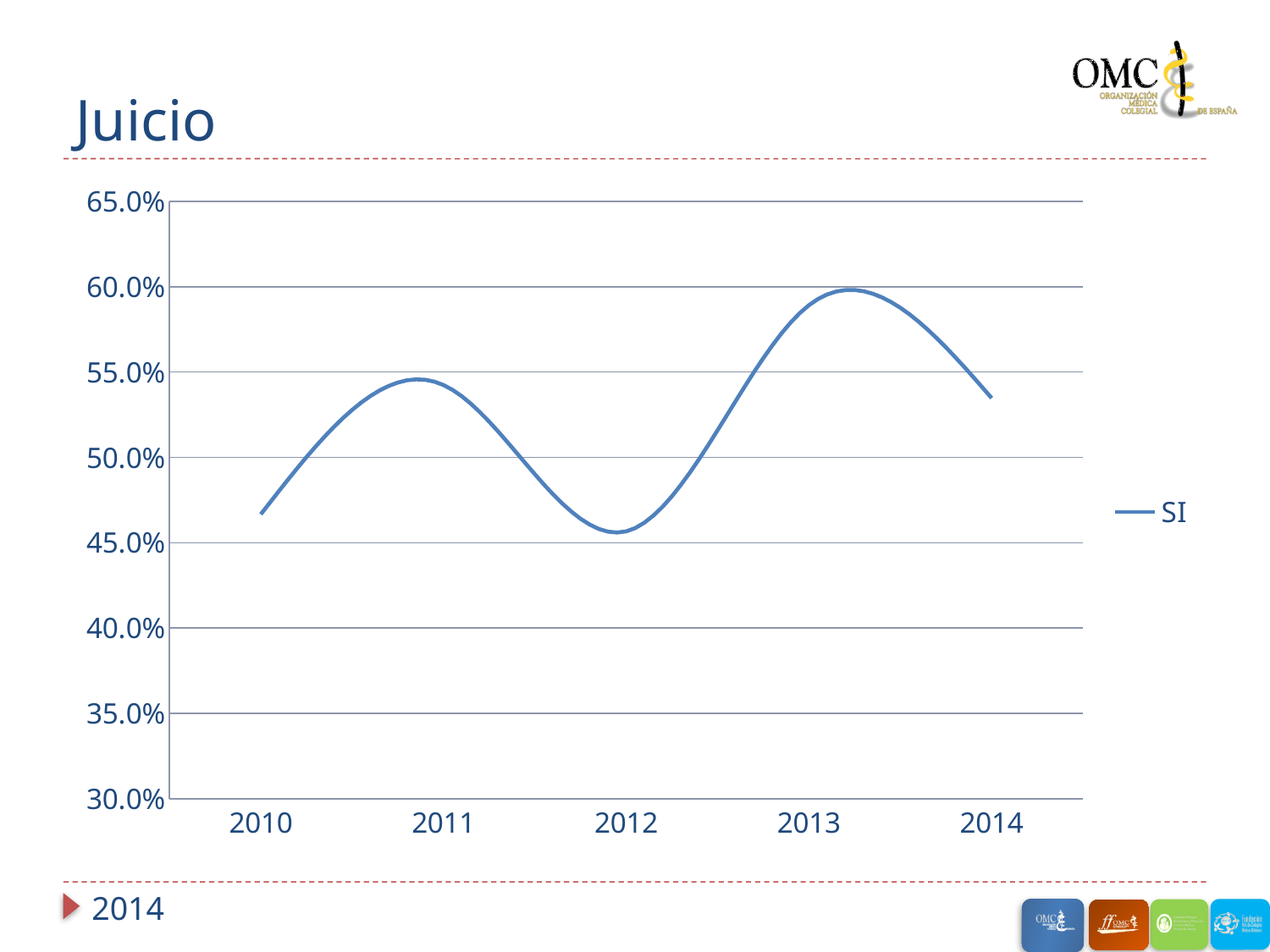
Which year has a larger value for SI, 2011 or 2013? 2013 Does the value for SI rise or fall from 2013 to 2014? fall Is the value for SI in 2012 greater or less than 50.0%? less How many series does the legend list? 1 Is the value for SI in 2014 greater or less than 55.0%? less Is the value for SI in 2010 greater or less than 50.0%? less Which year has the highest value for SI? 2013 Which year has the lowest value for SI? 2012 How many years are plotted on the x axis? 5 What kind of chart is shown on the slide? line chart